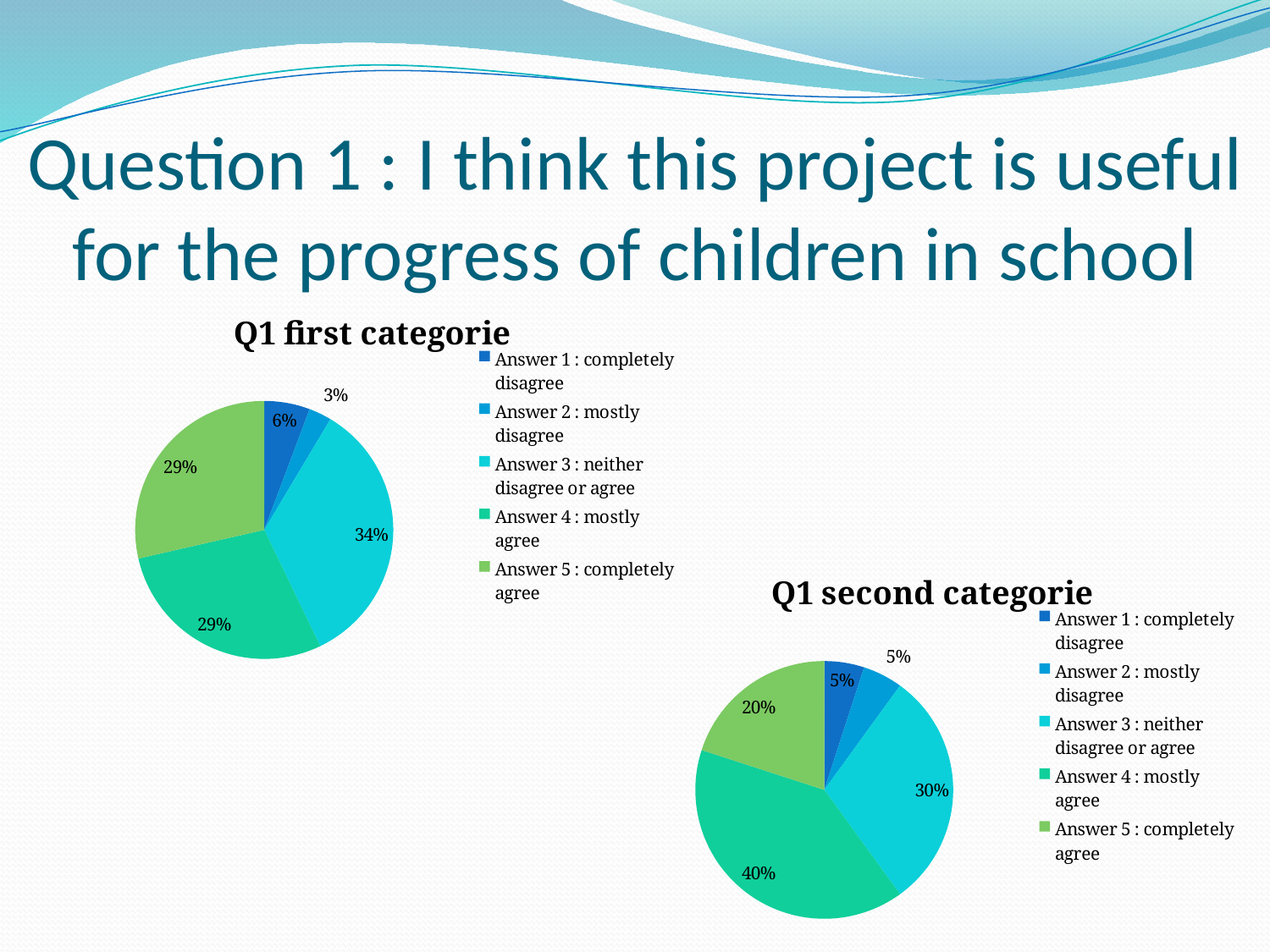
In the 'Q1 first categorie' chart, what percentage is shown for Answer 2 : mostly disagree? 3% How many entries does the legend of the 'Q1 first categorie' chart list? 5 What type of chart is 'Q1 second categorie'? Pie chart In the 'Q1 second categorie' chart, which answer has the largest share? Answer 4 : mostly agree In the 'Q1 second categorie' chart, what percentage is shown for Answer 5 : completely agree? 20% In the 'Q1 second categorie' chart, what is the difference in percentage points between Answer 4 : mostly agree and Answer 3 : neither disagree or agree? 10 In the 'Q1 first categorie' chart, what percentage is shown for Answer 3 : neither disagree or agree? 34% In the 'Q1 first categorie' chart, what percentage is shown for Answer 1 : completely disagree? 6% In the 'Q1 first categorie' chart, which is larger: the share for Answer 3 : neither disagree or agree or the share for Answer 4 : mostly agree? Answer 3 : neither disagree or agree In the 'Q1 second categorie' chart, what percentage is shown for Answer 4 : mostly agree? 40% In the 'Q1 first categorie' chart, which answer has the largest share? Answer 3 : neither disagree or agree In the 'Q1 first categorie' chart, which answer has the smallest share? Answer 2 : mostly disagree